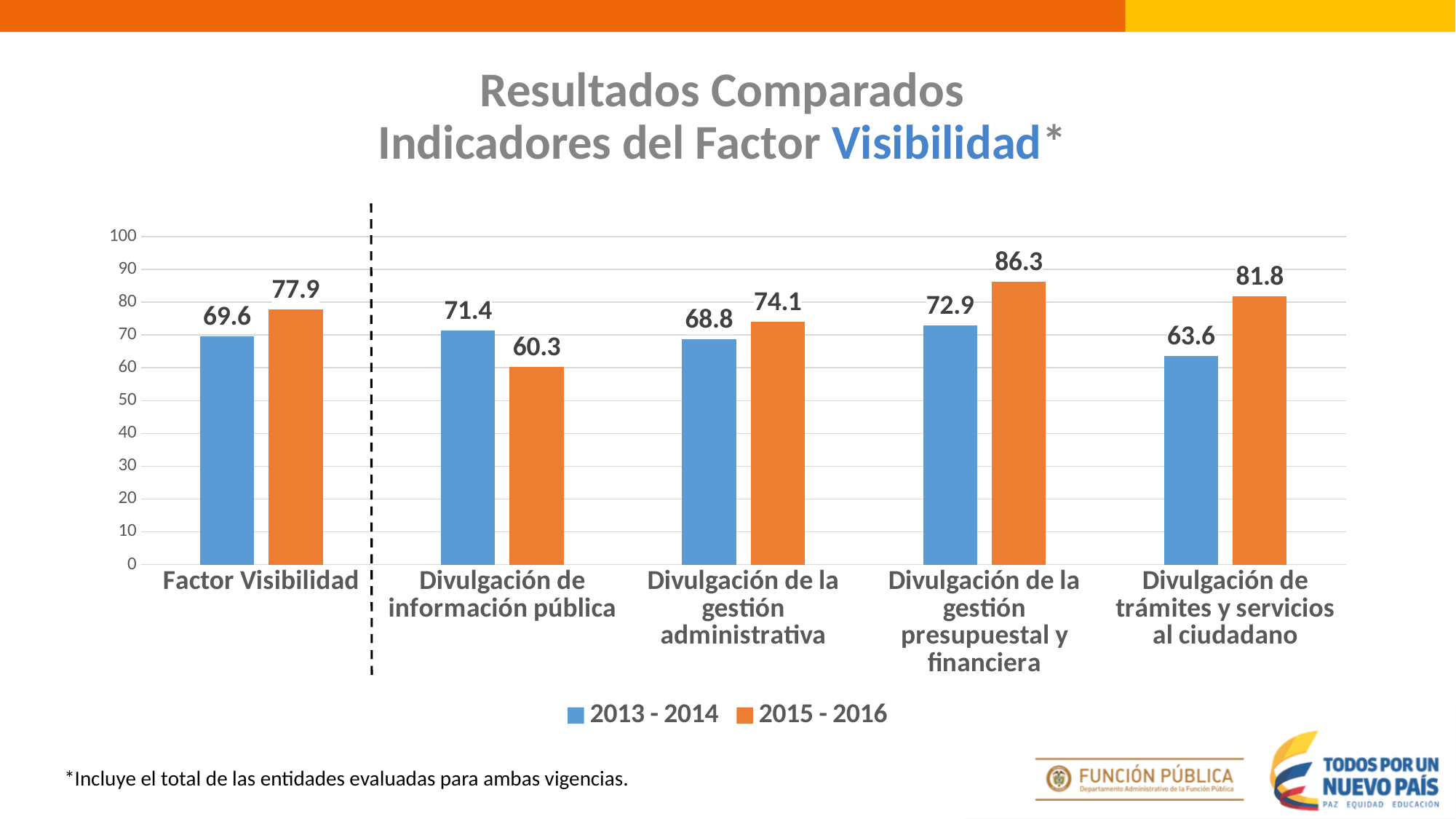
How many series does the legend list? 2 How many categories are shown on the x axis? 5 What is the 2015 - 2016 value for Divulgación de la gestión presupuestal y financiera? 86.3 Which colour represents the 2015 - 2016 series? Orange What is the 2013 - 2014 value for Factor Visibilidad? 69.6 What is the difference between the 2015 - 2016 and 2013 - 2014 values for Divulgación de trámites y servicios al ciudadano? 18.2 Which category has the lowest 2013 - 2014 value? Divulgación de trámites y servicios al ciudadano What is the 2015 - 2016 value for Divulgación de información pública? 60.3 For Divulgación de información pública, which series has the larger value, 2013 - 2014 or 2015 - 2016? 2013 - 2014 What is the 2013 - 2014 value for Divulgación de trámites y servicios al ciudadano? 63.6 Which category has the highest 2015 - 2016 value? Divulgación de la gestión presupuestal y financiera What kind of chart is shown on the slide? Bar chart